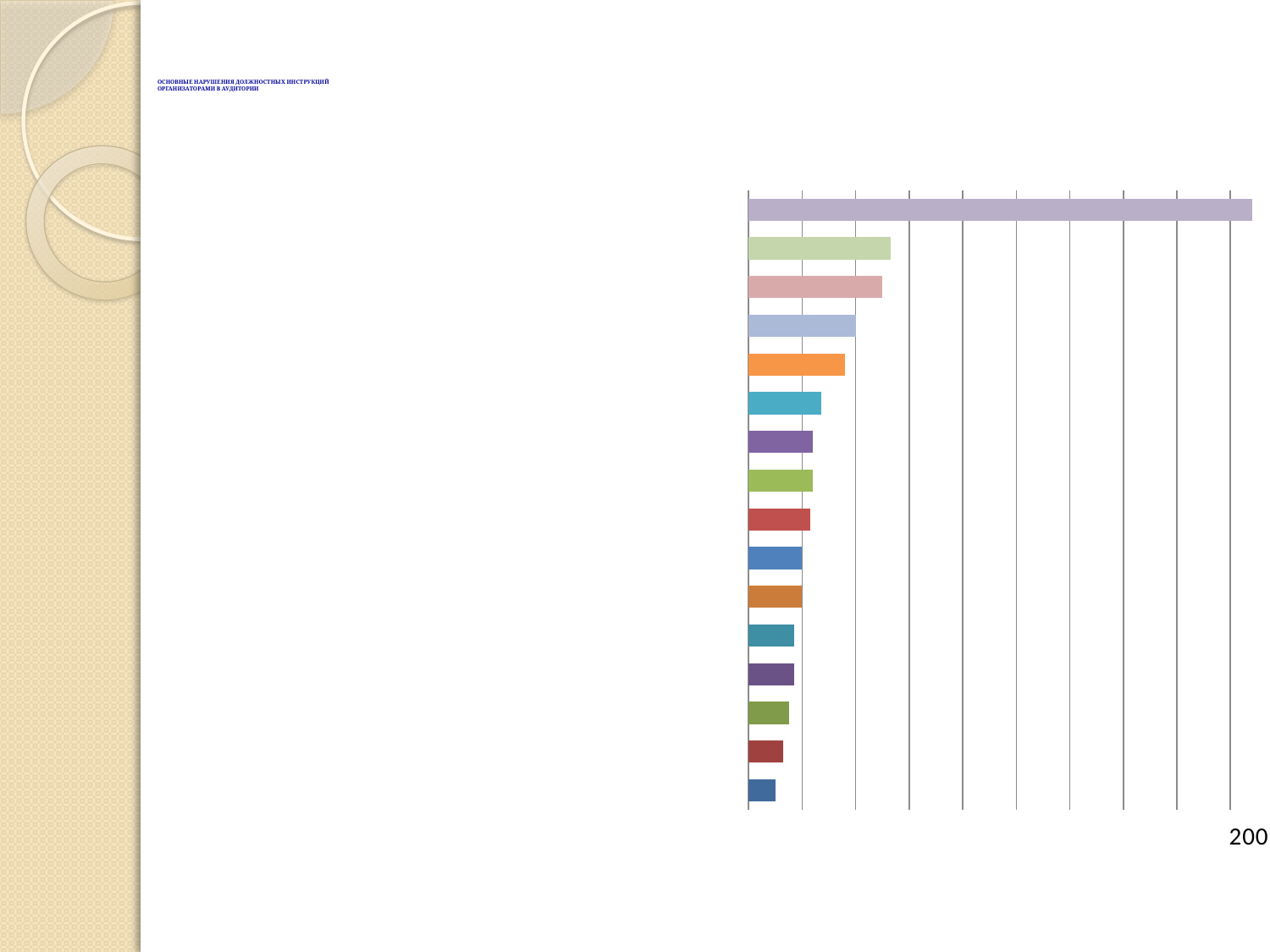
What kind of chart is shown on the slide? Bar chart Are the bars in the chart oriented horizontally or vertically? Horizontally How many bars does the chart contain? 16 What is the title text shown at the top left of the slide? ОСНОВНЫЕ НАРУШЕНИЯ ДОЛЖНОСТНЫХ ИНСТРУКЦИЙ ОРГАНИЗАТОРАМИ В АУДИТОРИИ Which bar in the chart is the longest? The top (first) bar Which bar in the chart is the shortest? The bottom (last) bar Do the bar lengths increase or decrease going from the top of the chart to the bottom? Decrease Is the top bar longer or shorter than the second bar from the top? Longer